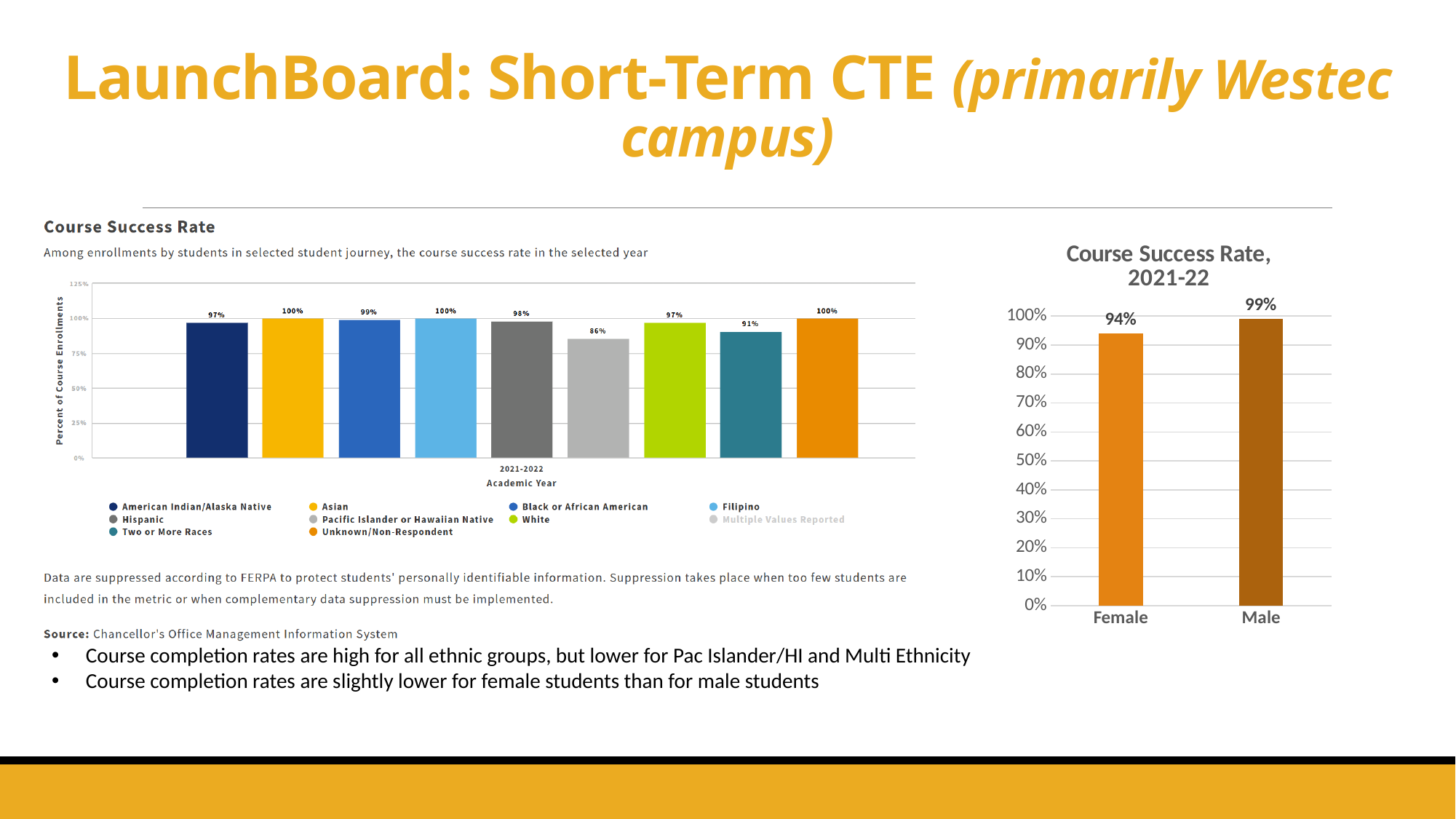
In the Course Success Rate, 2021-22 chart on the right, what is the value for Male? 99% In the Course Success Rate chart on the left, what is the difference between the Asian and Pacific Islander or Hawaiian Native values? 14% In the Course Success Rate chart on the left, which group has the lowest course success rate? Pacific Islander or Hawaiian Native In the Course Success Rate, 2021-22 chart on the right, which category has the higher value, Female or Male? Male In the Course Success Rate chart on the left, what is the value for Hispanic? 98% In the Course Success Rate chart on the left, what is the value for Pacific Islander or Hawaiian Native? 86% What kind of chart is the Course Success Rate, 2021-22 chart on the right? Bar chart In the Course Success Rate chart on the left, how many bars are plotted? 9 In the Course Success Rate chart on the left, what is the value for Two or More Races? 91% In the Course Success Rate chart on the left, which academic year is shown on the x axis? 2021-2022 In the Course Success Rate, 2021-22 chart on the right, what is the value for Female? 94% In the Course Success Rate, 2021-22 chart on the right, what is the difference between the Male and Female values? 5%